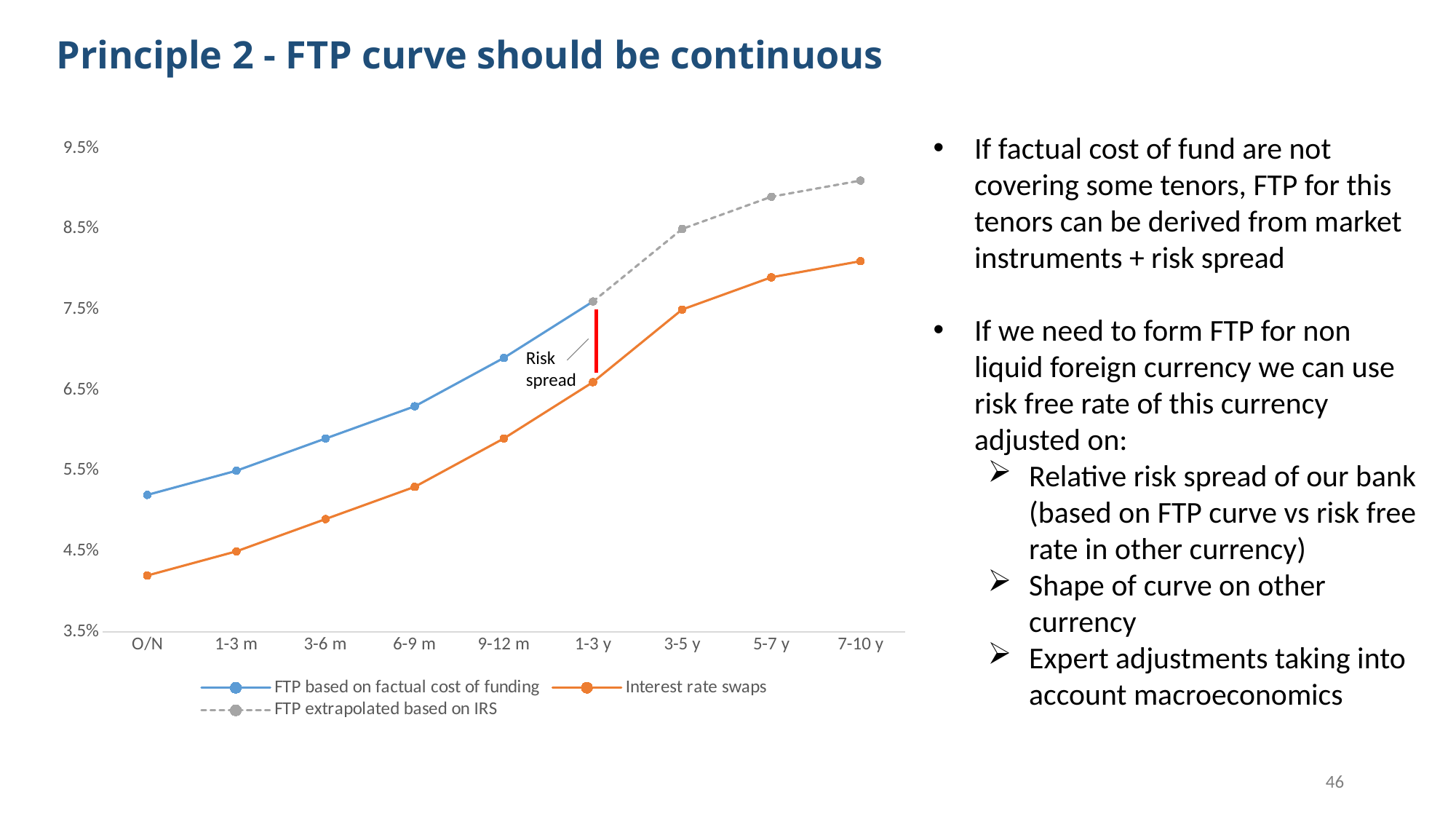
Is the value of FTP based on factual cost of funding at O/N greater or less than 5.5%? less How many series does the chart legend list? 3 Do the values of the Interest rate swaps series rise or fall as the tenor increases along the x axis? rise At which tenor is the Interest rate swaps series lowest? O/N Is the value of Interest rate swaps at O/N greater or less than 4.5%? less What does the red vertical segment between the curves at 1-3 y represent, according to the chart annotation? Risk spread Is the value of FTP based on factual cost of funding at 9-12 m greater or less than 6.5%? greater At O/N, which series has the higher value: FTP based on factual cost of funding or Interest rate swaps? FTP based on factual cost of funding What kind of chart is shown on the slide? line chart How many tenor categories are shown on the x axis? 9